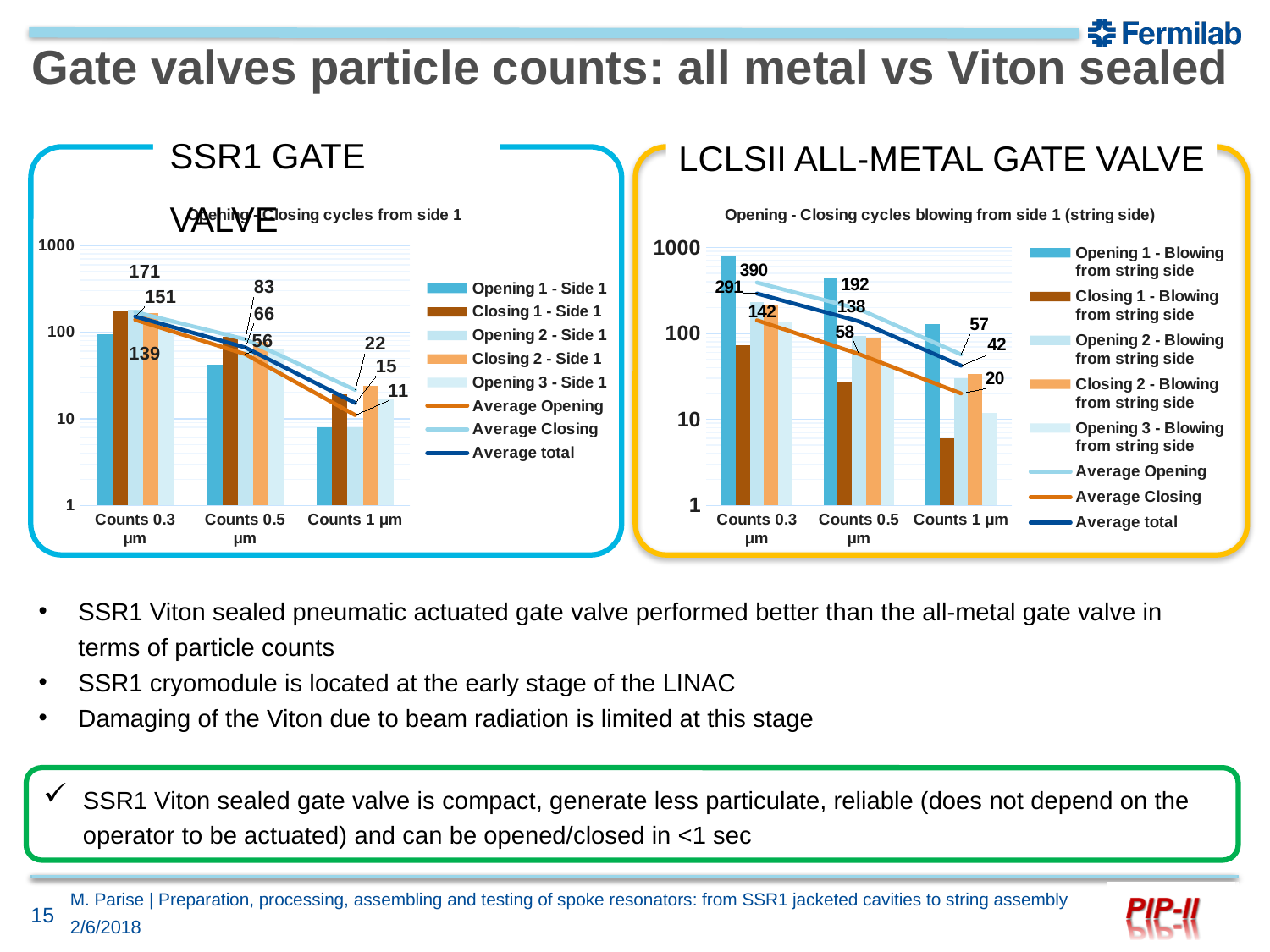
In the right chart 'Opening - Closing cycles blowing from side 1 (string side)', is the value of Closing 1 - Blowing from string side at Counts 1 µm greater or less than 10? less How many categories are shown on the x axis of the right chart titled 'Opening - Closing cycles blowing from side 1 (string side)'? 3 In the right chart 'Opening - Closing cycles blowing from side 1 (string side)', do the labelled average values rise or fall from Counts 0.3 µm to Counts 1 µm? fall How many series does the legend of the left chart 'Opening - Closing cycles from side 1' list? 8 In the left chart 'Opening - Closing cycles from side 1', what is the lowest labelled value at Counts 1 µm? 11 In the right chart 'Opening - Closing cycles blowing from side 1 (string side)', is the value of Opening 1 - Blowing from string side at Counts 0.3 µm greater or less than 100? greater In the right chart 'Opening - Closing cycles blowing from side 1 (string side)', what is the highest labelled value at Counts 0.3 µm? 390 What kind of chart is the left chart titled 'Opening - Closing cycles from side 1'? bar chart with line series In the right chart 'Opening - Closing cycles blowing from side 1 (string side)', which is larger at Counts 0.3 µm: Opening 1 - Blowing from string side or Closing 1 - Blowing from string side? Opening 1 - Blowing from string side In the left chart 'Opening - Closing cycles from side 1', which is larger at Counts 0.3 µm: Opening 1 - Side 1 or Closing 1 - Side 1? Closing 1 - Side 1 What is the maximum value shown on the y axis of the left chart 'Opening - Closing cycles from side 1'? 1000